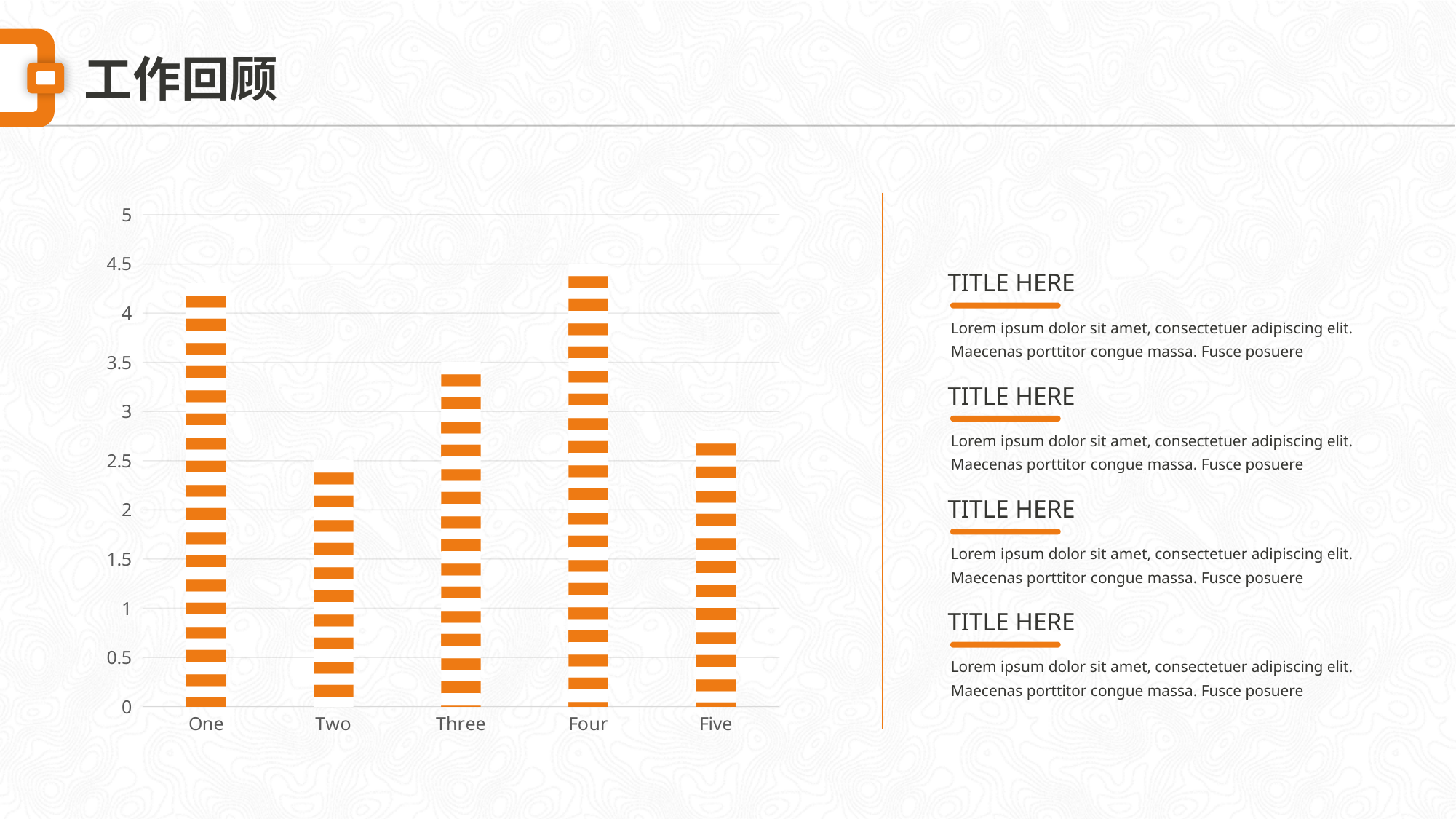
What kind of chart is shown on the slide? bar chart Is the value for Four greater or less than 4? greater Is the value for One greater or less than 4? greater Which is larger, the value for Five or the value for Two? Five Which category has the lowest bar in the chart? Two Which category has the highest bar in the chart? Four Is the value for Five greater or less than 2.5? greater What colour are the bars in the chart? orange Which is larger, the value for Three or the value for Five? Three How many categories are shown on the x axis of the chart? 5 Which is larger, the value for One or the value for Three? One